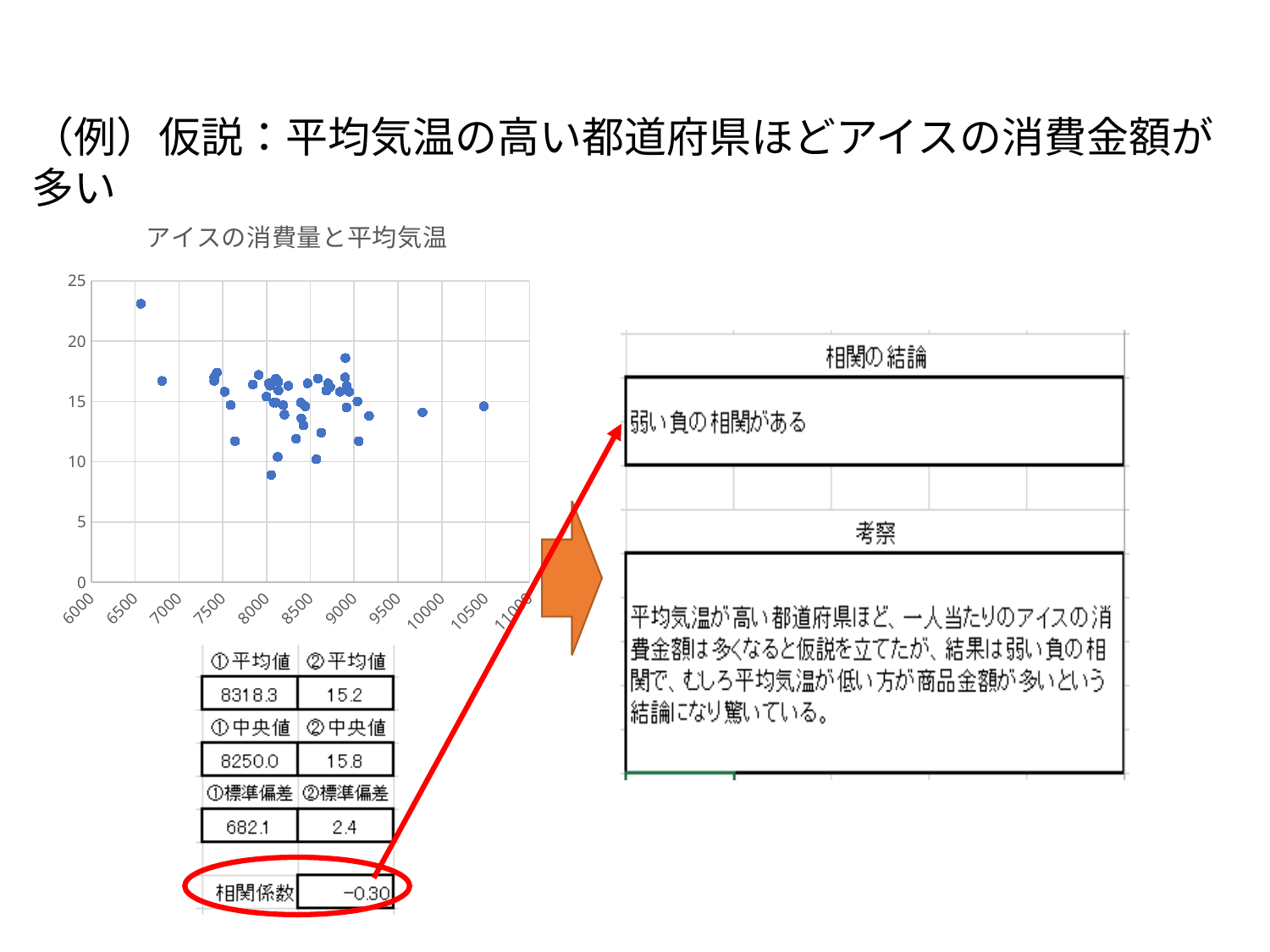
What is the title of the chart? アイスの消費量と平均気温 Is the y value of the highest point on the chart greater or less than 20? greater Is the x value of the rightmost point on the chart greater or less than 10000? greater Is the x value of the leftmost point on the chart greater or less than 7000? less Do the y values generally rise or fall as the x values increase along the x axis? fall What is the maximum value shown on the y axis of the chart? 25 What kind of chart is shown on the slide? scatter chart How many data series are plotted on the chart? 1